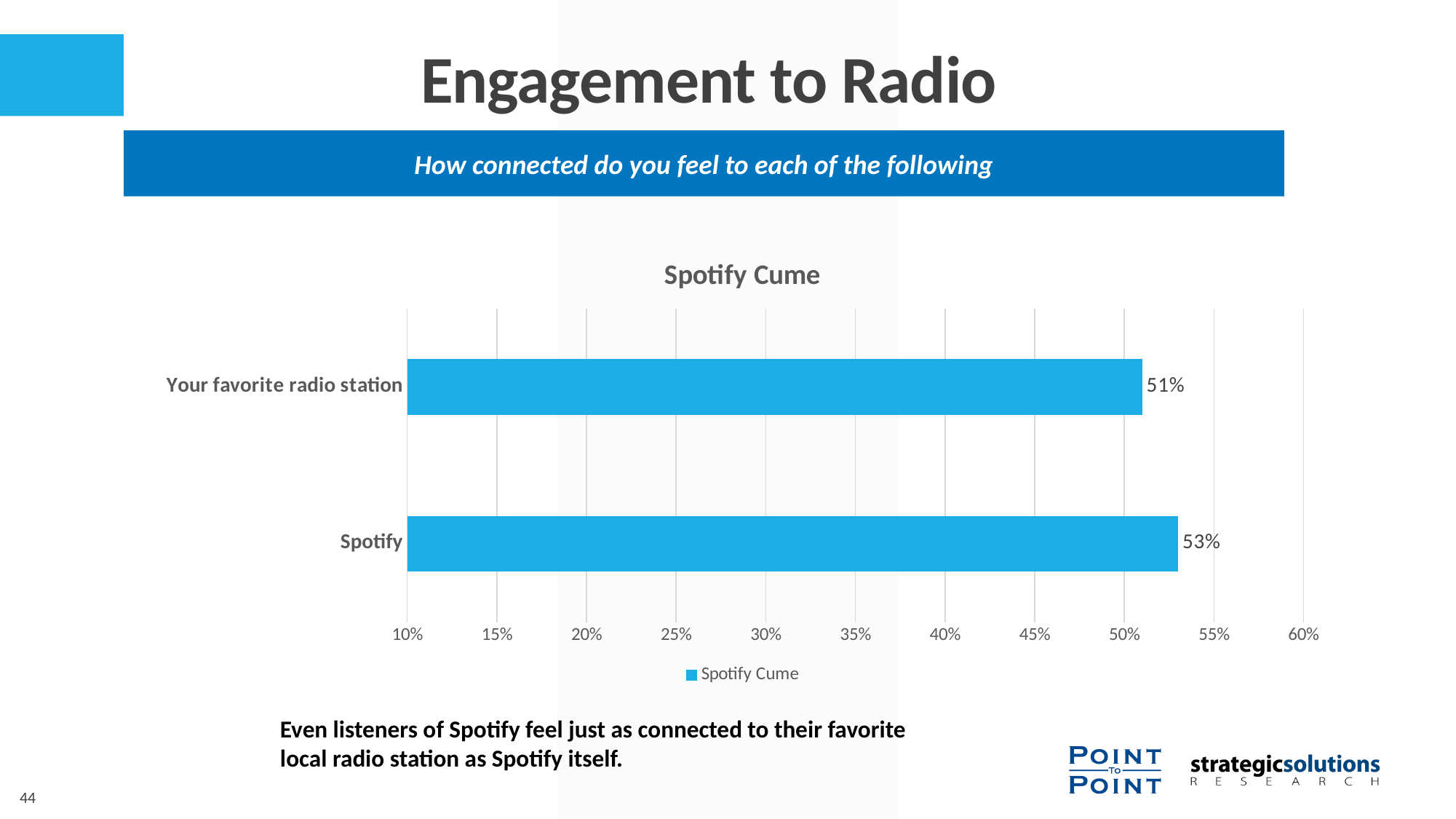
What kind of chart is shown on the slide? Bar chart Which is larger, the value for Spotify or the value for Your favorite radio station? Spotify What is the value for Spotify? 53% Is the value for Spotify greater or less than 55%? less How many categories are shown in the chart? 2 Which category has the lowest value? Your favorite radio station What is the difference between the values for Spotify and Your favorite radio station? 2% What is the title of the chart? Spotify Cume What is the value for Your favorite radio station? 51% Which category has the highest value? Spotify How many series does the legend list? 1 Is the value for Your favorite radio station greater or less than 40%? greater